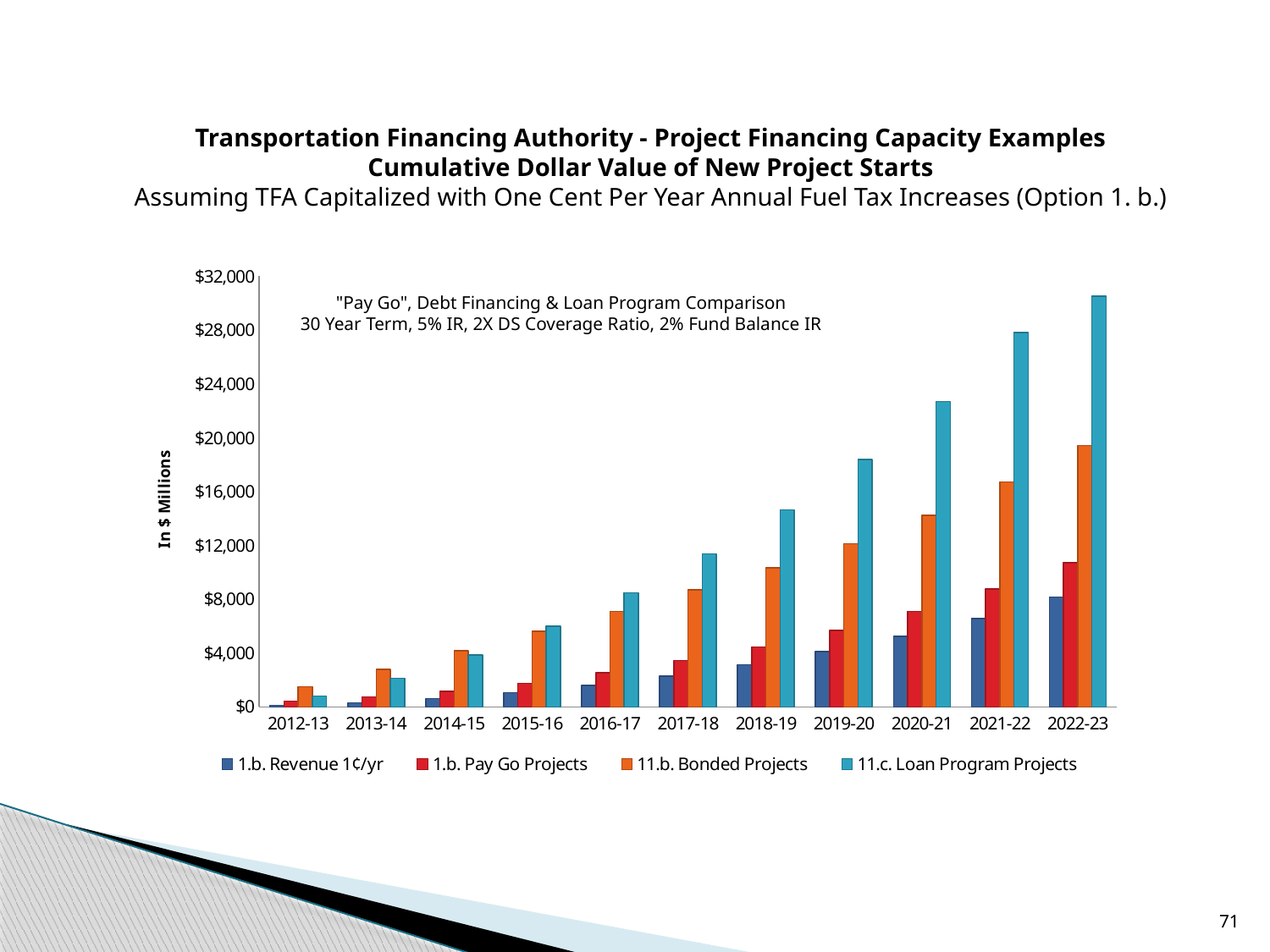
In 2013-14, which is larger: 11.b. Bonded Projects or 11.c. Loan Program Projects? 11.b. Bonded Projects Is the value for 11.c. Loan Program Projects in 2022-23 greater or less than $28,000? greater Which series has the lowest value in 2022-23? 1.b. Revenue 1¢/yr Is the value for 11.c. Loan Program Projects in 2019-20 greater or less than $16,000? greater In 2020-21, which is larger: 11.c. Loan Program Projects or 11.b. Bonded Projects? 11.c. Loan Program Projects How many fiscal years are shown on the x axis? 11 Do the values for 11.c. Loan Program Projects rise or fall from 2012-13 to 2022-23? rise Is the value for 11.b. Bonded Projects in 2022-23 greater or less than $16,000? greater How many series does the legend list? 4 In which year is the value for 11.c. Loan Program Projects highest? 2022-23 What kind of chart is shown on the slide? bar chart